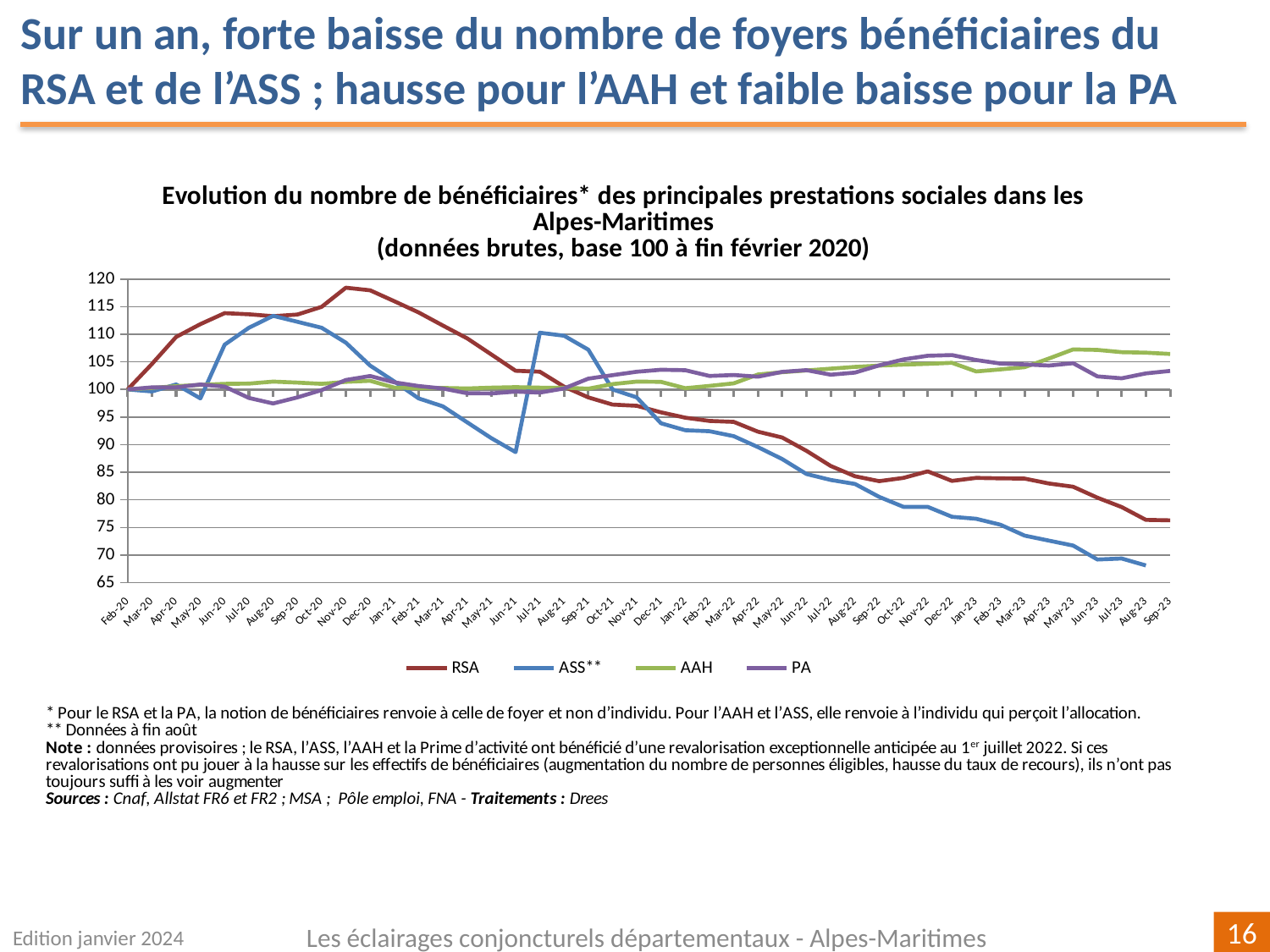
Is the value for ASS** in Jun-21 greater or less than 90? less Is the value for RSA in Sep-23 greater or less than 80? less How many series does the legend list? 4 Is the value for RSA in Nov-20 greater or less than 115? greater What is the base value of the index at the end of February 2020, according to the chart title? 100 Which series are listed in the legend? RSA, ASS**, AAH, PA What kind of chart is shown on the slide? Line chart Which series has the highest value in Sep-23? AAH Which series has the lowest value at the end of the period shown? ASS** Does the RSA series rise or fall overall between Nov-20 and Sep-23? Fall